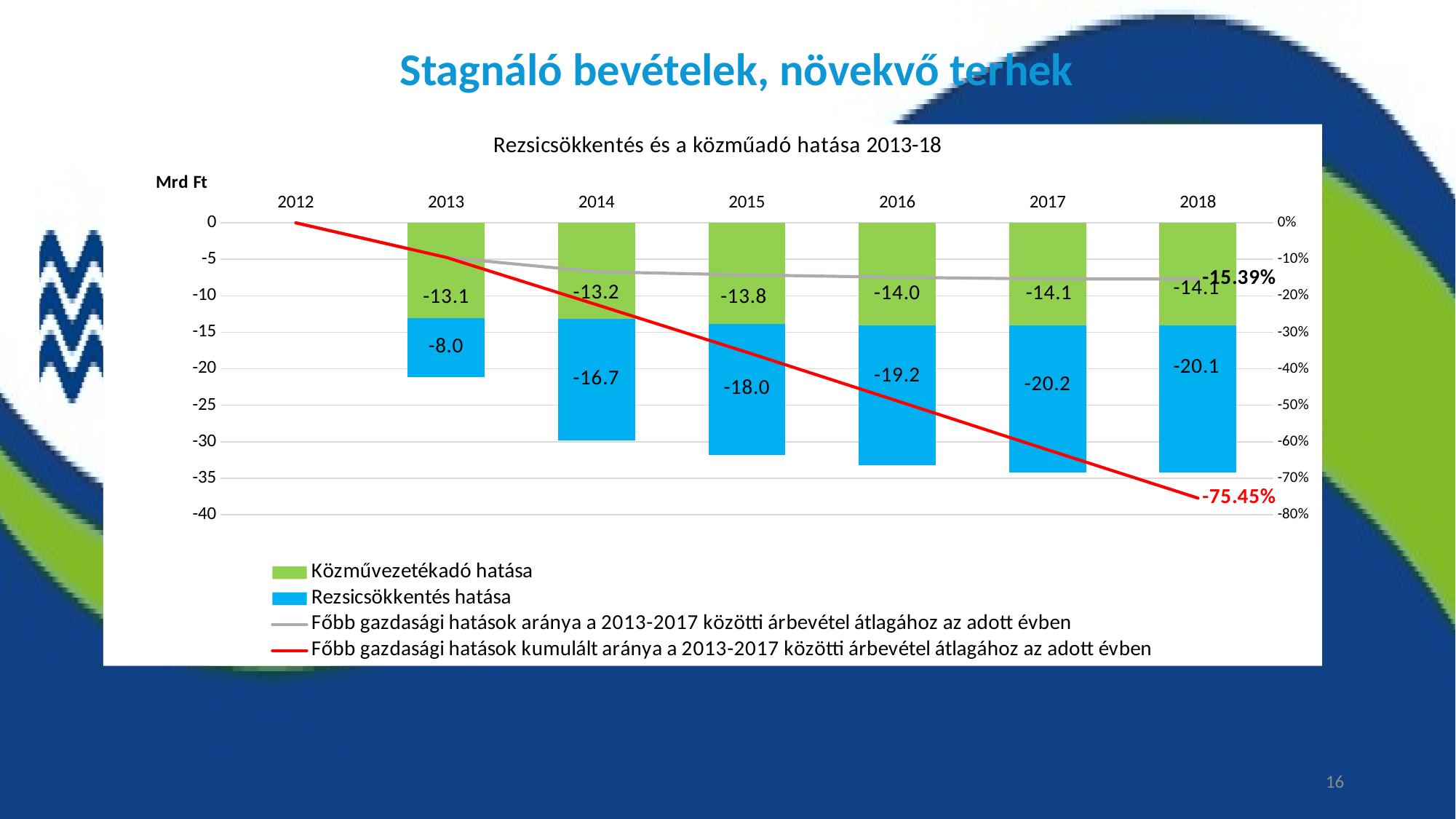
What is the total of the stacked bar for 2018 (Közművezetékadó hatása plus Rezsicsökkentés hatása)? -34.2 What value is labelled on the grey line (Főbb gazdasági hatások aránya) in 2018? -15.39% What kind of chart is used for the Közművezetékadó hatása and Rezsicsökkentés hatása series? Stacked bar chart How many series does the legend list? 4 By how much does the absolute value of Rezsicsökkentés hatása change between 2013 (-8.0) and 2014 (-16.7)? 8.7 What is the value of Közművezetékadó hatása for 2013? -13.1 Does the red cumulative line rise or fall from 2012 to 2018? Falls What is the value of Rezsicsökkentés hatása for 2015? -18.0 In which year is the Rezsicsökkentés hatása value the most negative? 2017 What value does the red cumulative line (Főbb gazdasági hatások kumulált aránya) reach in 2018? -75.45% What is the total of the stacked bar for 2013? -21.1 How many years have stacked bars plotted in the chart? 6